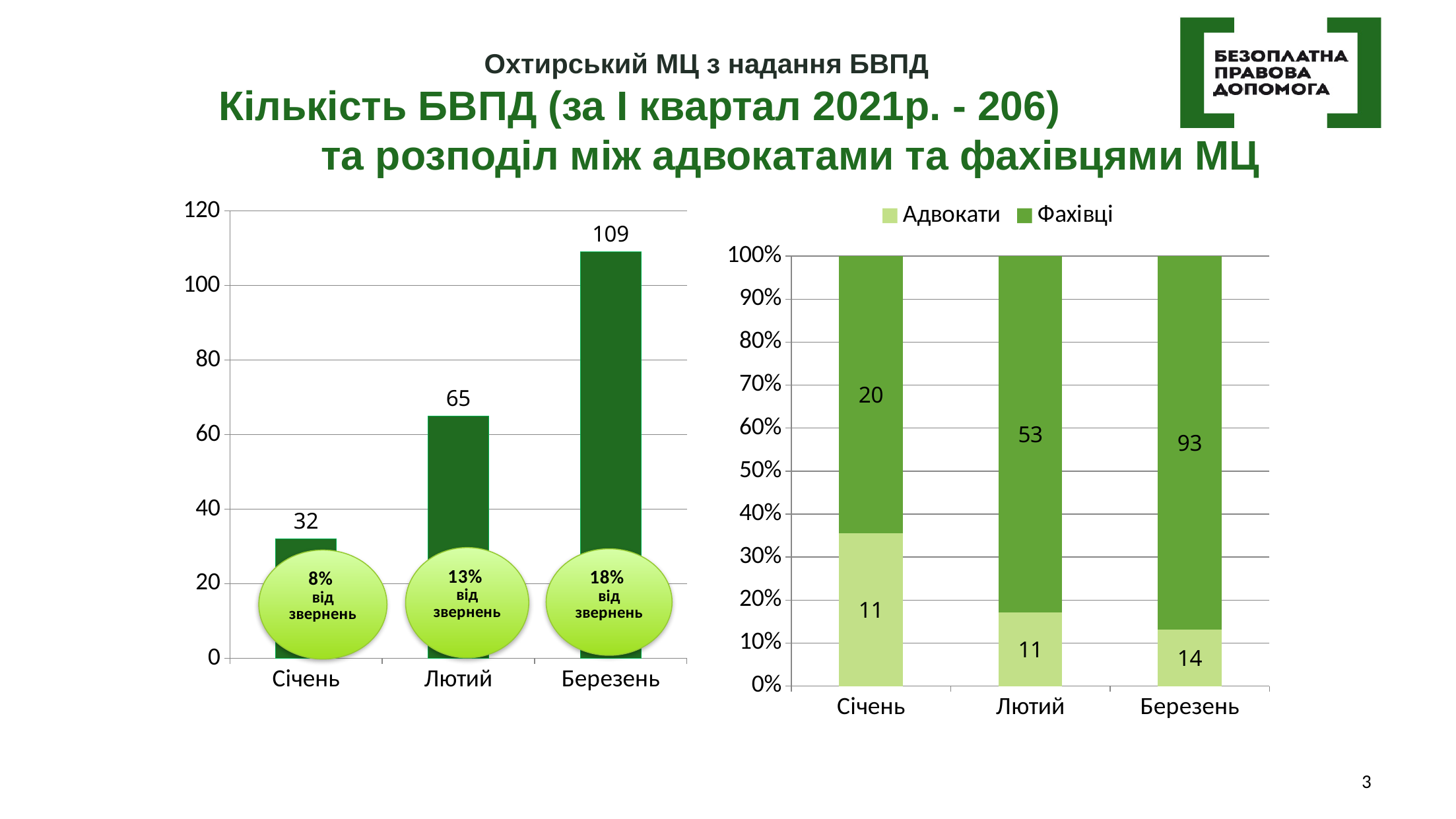
In the left bar chart, what percentage of звернень is shown in the circle for Лютий? 13% How many series does the legend of the right stacked bar chart list? 2 What type of chart is the chart on the left? bar chart In the right stacked bar chart, what is the value for Адвокати in Лютий? 11 In the right stacked bar chart, what is the value for Фахівці in Березень? 93 In the left bar chart, what is the value for Січень? 32 In the left bar chart, do the values rise or fall from Січень to Березень? rise In the right stacked bar chart, which is larger in Січень: Адвокати or Фахівці? Фахівці In the left bar chart, what is the value for Березень? 109 In the left bar chart, which month has the lowest value? Січень In the left bar chart, what is the difference between the values for Березень and Лютий? 44 In the left bar chart, which month has the highest value? Березень